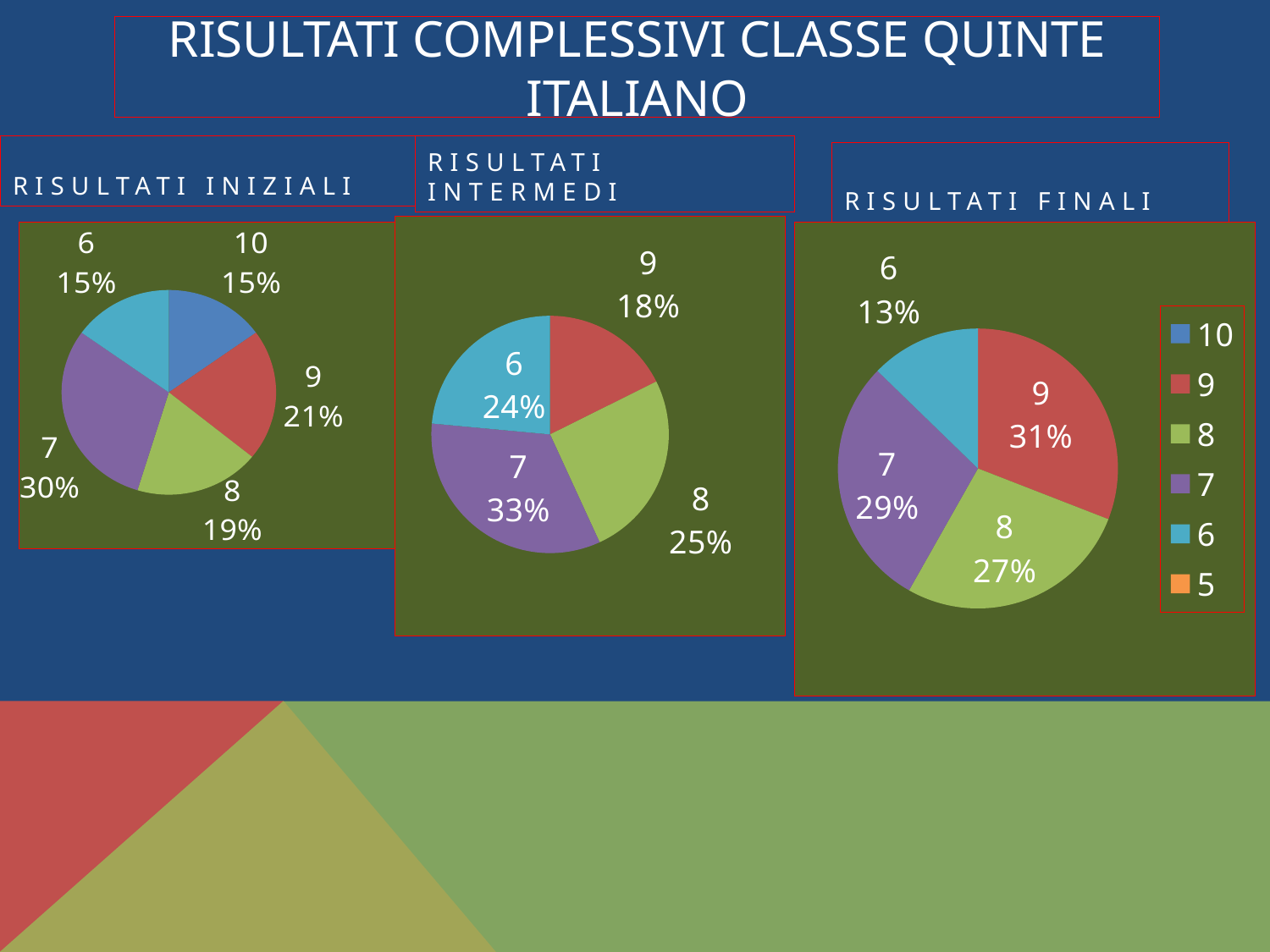
In the RISULTATI INIZIALI chart, which grade has the largest slice? 7 In the RISULTATI INTERMEDI chart, what is the difference between the shares of grade 7 and grade 8? 8% In the RISULTATI INTERMEDI chart, how many slices does the pie have? 4 In the RISULTATI INIZIALI chart, what share of the pie does grade 7 have? 30% What type of chart is used for RISULTATI INIZIALI? Pie chart In the RISULTATI INTERMEDI chart, what share of the pie does grade 6 have? 24% In the RISULTATI FINALI chart, which grade has the smallest slice? 6 In the RISULTATI INTERMEDI chart, which grade has the smallest slice? 9 In the RISULTATI FINALI chart, which slice is larger, grade 9 or grade 8? 9 In the RISULTATI FINALI chart, what share of the pie does grade 9 have? 31% In the RISULTATI FINALI chart, how many entries does the legend list? 6